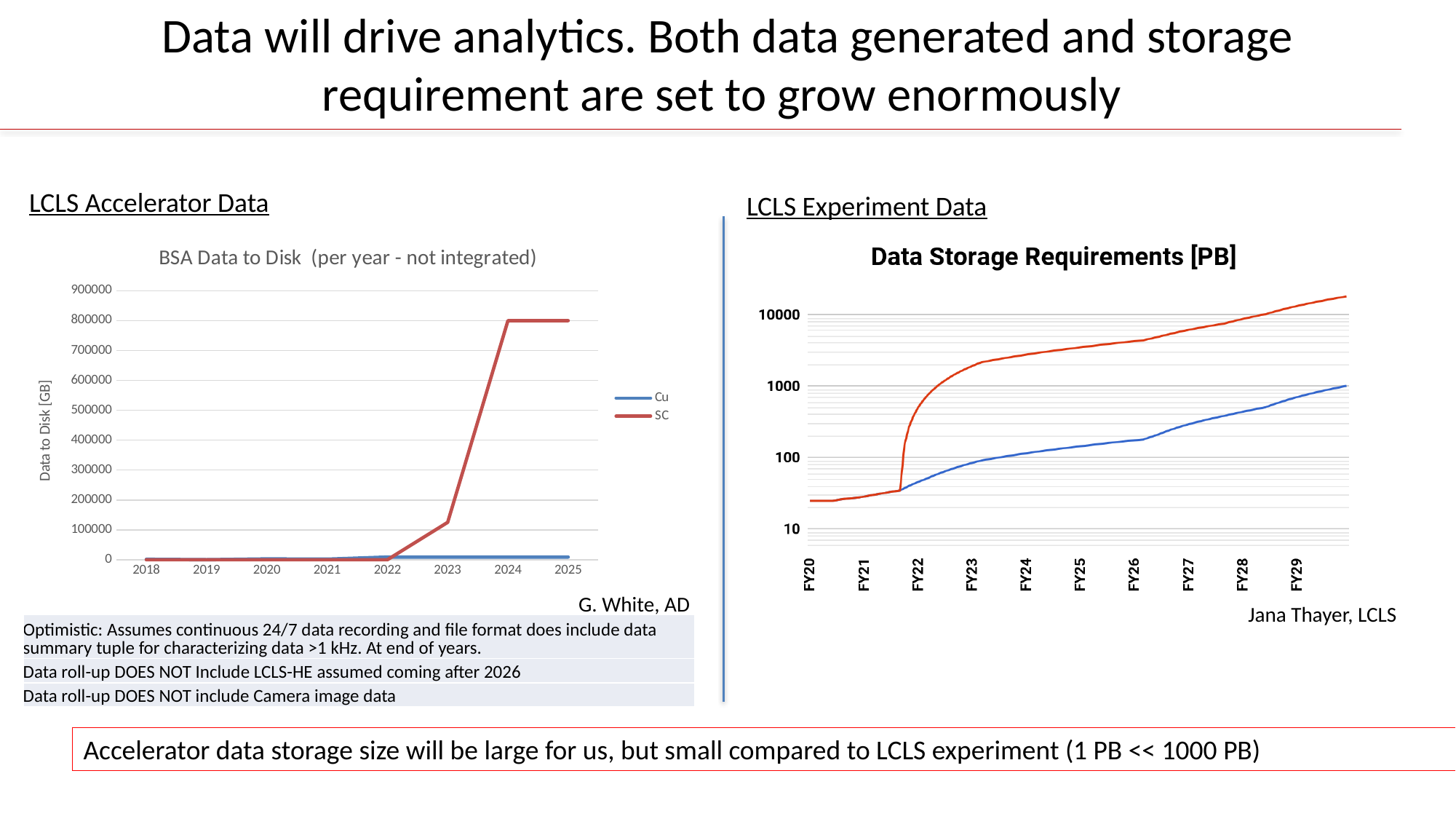
In the 'Data Storage Requirements [PB]' chart, how many fiscal years are labelled on the x axis? 10 In the 'BSA Data to Disk' chart, what is the y-axis label? Data to Disk [GB] In the 'BSA Data to Disk' chart, what is the value of the SC series in 2024? 800000 In the 'Data Storage Requirements [PB]' chart, does the blue line rise or fall from FY20 to FY29? rise In the 'BSA Data to Disk' chart, what is the value of the SC series in 2025? 800000 What type of chart is the 'BSA Data to Disk (per year - not integrated)' chart? line chart In the 'BSA Data to Disk' chart, how many years are shown on the x axis? 8 What type of chart is the 'Data Storage Requirements [PB]' chart? line chart In the 'BSA Data to Disk' chart, is the value of the SC series in 2023 greater or less than 200000? less In the 'Data Storage Requirements [PB]' chart, is the value of the red line at FY23 greater or less than 1000? greater In the 'BSA Data to Disk' chart, which series is higher in 2024, Cu or SC? SC How many series does the legend of the 'BSA Data to Disk' chart list? 2